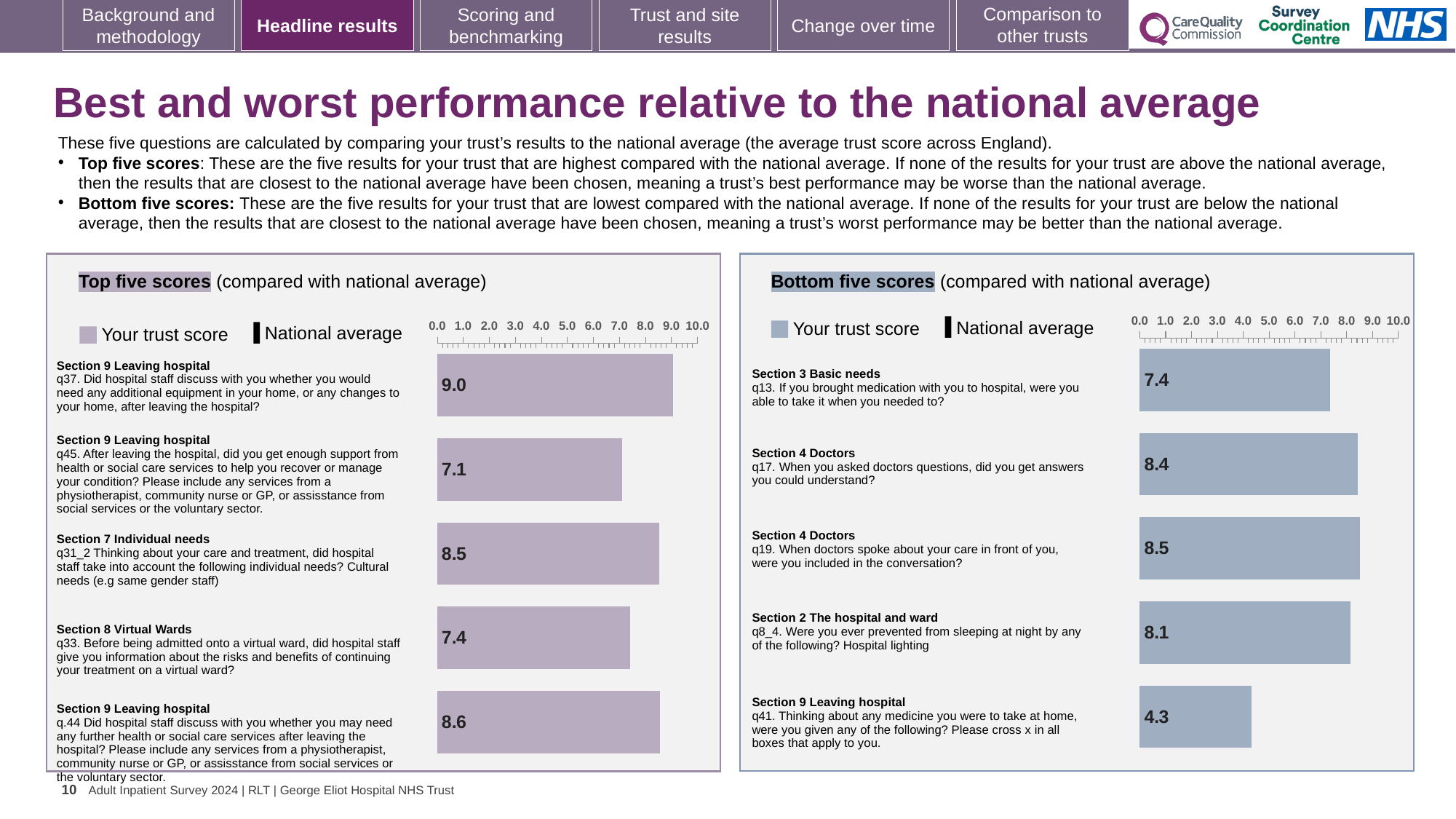
In the Bottom five scores chart, what is the trust score for q41 (Thinking about any medicine you were to take at home)? 4.3 In the Top five scores chart, what is the trust score for q33 (Before being admitted onto a virtual ward)? 7.4 What kind of chart is the Top five scores chart? Bar chart In the Bottom five scores chart, what is the difference between the trust scores for q19 and q41? 4.2 In the Bottom five scores chart, is the trust score for q13 greater or less than 5.0? greater In the Top five scores chart, which question has the highest trust score? q37 In the Bottom five scores chart, which question has the lowest trust score? q41 In the Top five scores chart, what is the difference between the trust scores for q37 and q45? 1.9 In the Top five scores chart, which question has the lowest trust score? q45 In the Top five scores chart, what is the trust score for q37 (Did hospital staff discuss with you whether you would need any additional equipment in your home)? 9.0 In the Top five scores chart, which has the larger trust score, q31_2 or q33? q31_2 How many bars are plotted in the Bottom five scores chart? 5